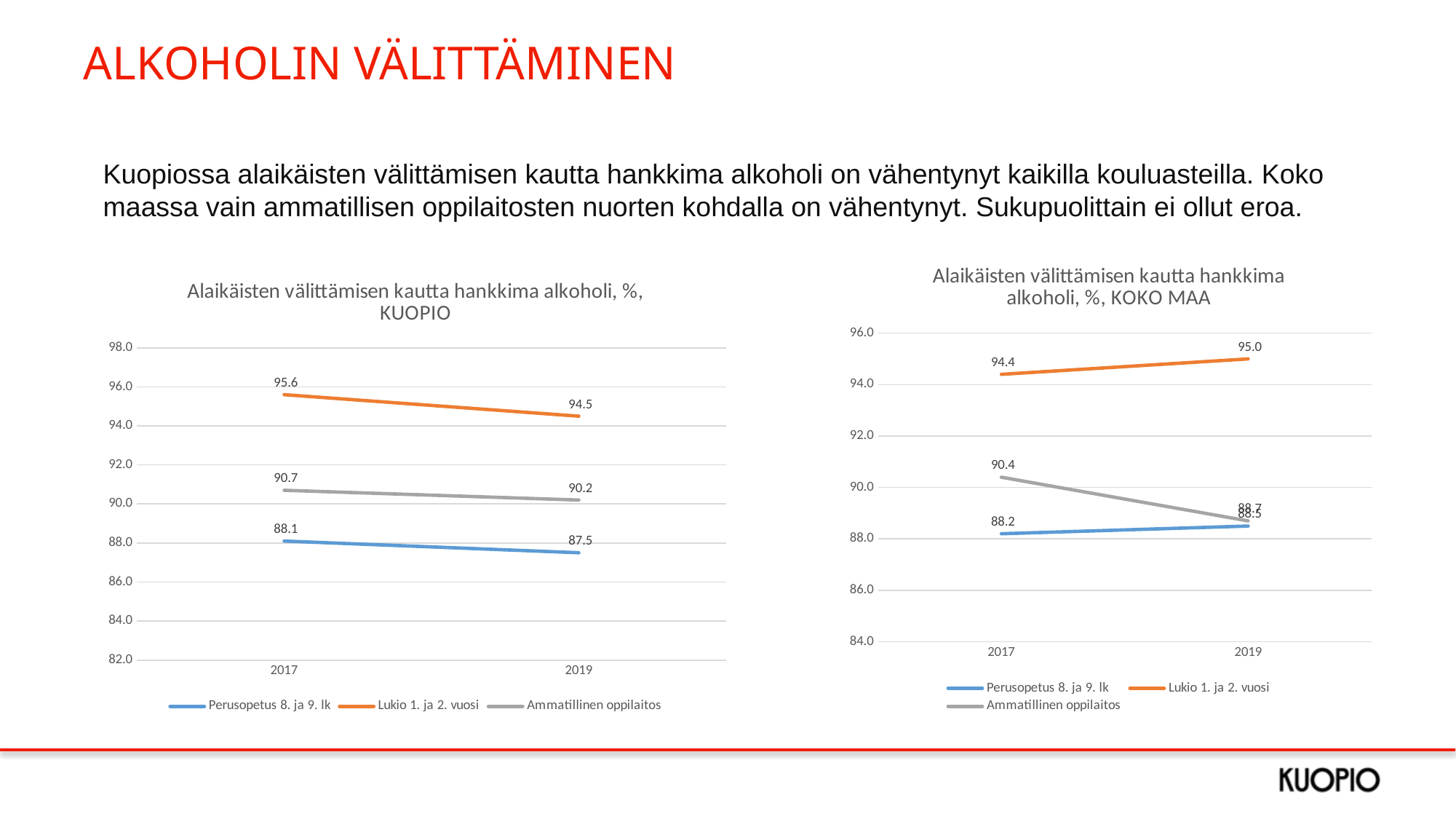
What kind of chart is the KOKO MAA chart? line chart In the KUOPIO chart, which series has the highest value in 2019? Lukio 1. ja 2. vuosi In the KUOPIO chart, what is the value for Ammatillinen oppilaitos in 2017? 90.7 In the KUOPIO chart, does the value for Perusopetus 8. ja 9. lk rise or fall from 2017 to 2019? fall In the KOKO MAA chart, what is the value for Lukio 1. ja 2. vuosi in 2019? 95.0 How many series does the legend of the KUOPIO chart list? 3 In the KOKO MAA chart, what is the value for Ammatillinen oppilaitos in 2017? 90.4 In the KUOPIO chart, what is the value for Perusopetus 8. ja 9. lk in 2019? 87.5 In the KUOPIO chart, by how much did the value for Lukio 1. ja 2. vuosi change from 2017 to 2019? 1.1 In the KOKO MAA chart, does the value for Lukio 1. ja 2. vuosi rise or fall from 2017 to 2019? rise In the KUOPIO chart, what is the value for Lukio 1. ja 2. vuosi in 2017? 95.6 In the KOKO MAA chart, which series has the lowest value in 2017? Perusopetus 8. ja 9. lk